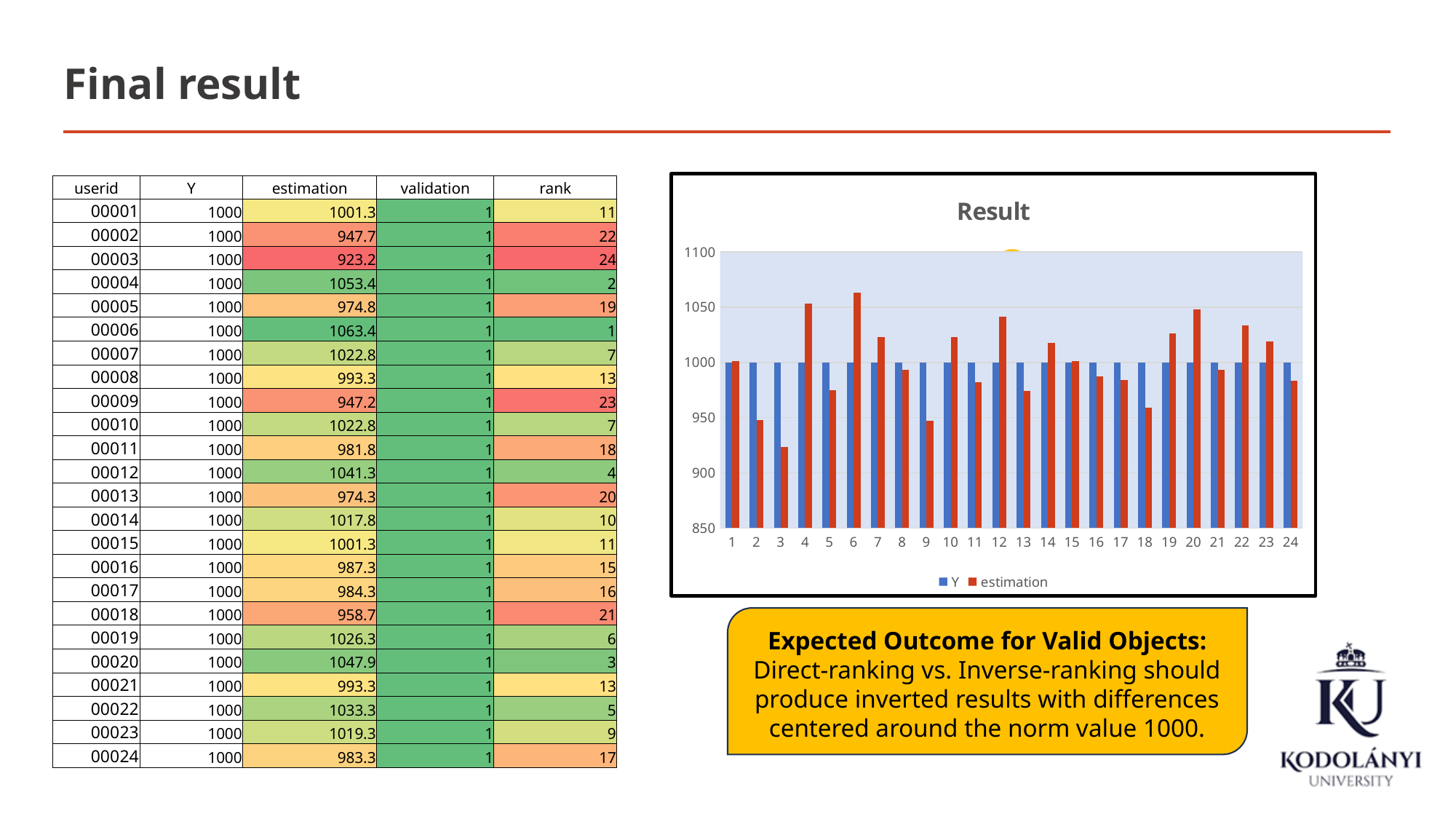
What is the title of the chart on the right of the slide? Result In the "Result" chart, is the estimation value for category 6 greater or less than 1050? greater In the "Result" chart, which series is shown in blue? Y In the "Result" chart, is the estimation value for category 12 greater or less than 1000? greater In the "Result" chart, is the estimation value for category 3 greater or less than 950? less How many categories are shown on the x axis of the "Result" chart? 24 What kind of chart is the "Result" chart? bar chart How many series does the legend of the "Result" chart list? 2 In the "Result" chart, which is larger: the estimation value for category 4 or for category 5? category 4 In the "Result" chart, which category has the highest estimation value? 6 In the "Result" chart, which category has the lowest estimation value? 3 In the "Result" chart, what is the Y value for category 1? 1000